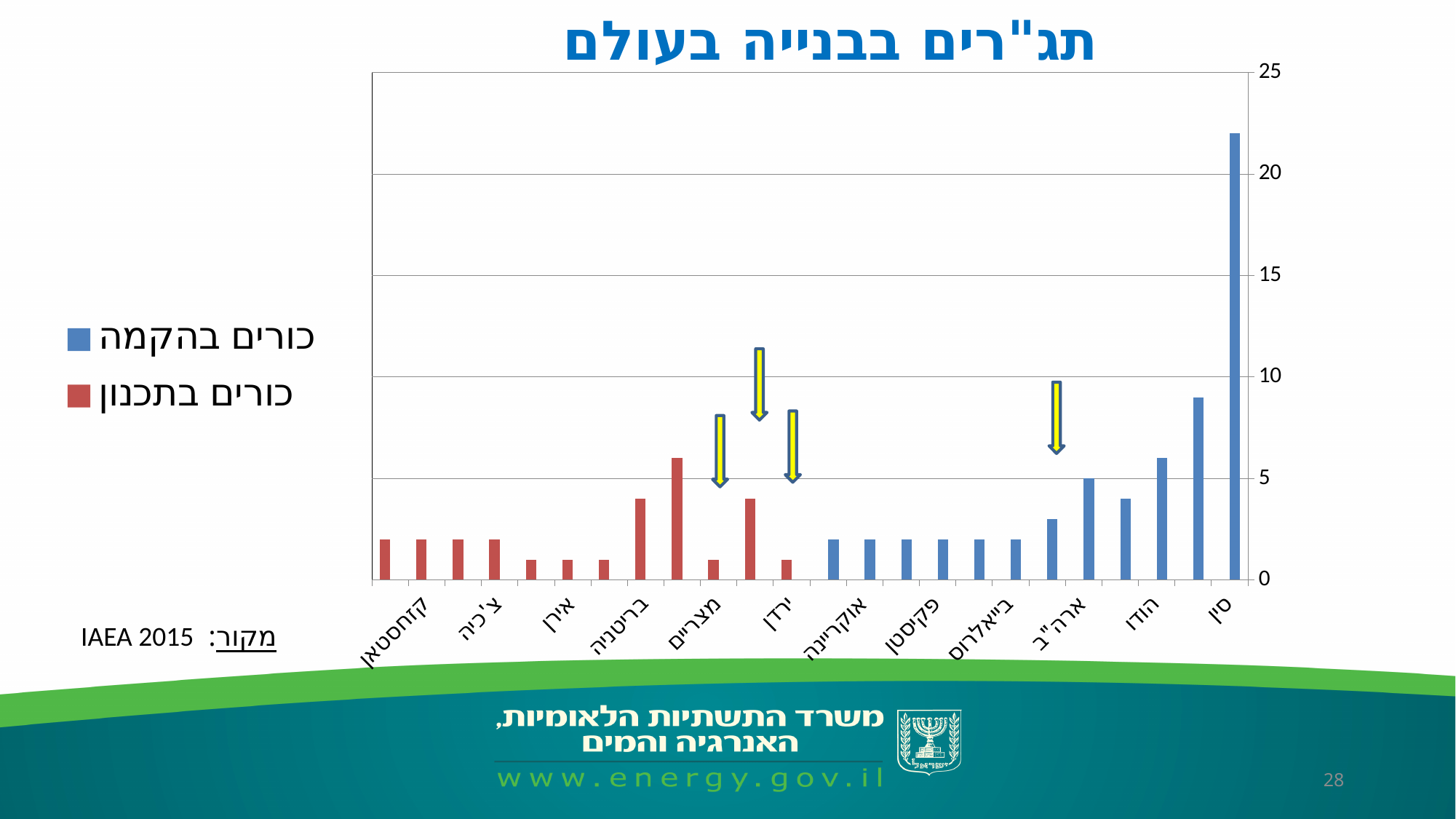
Is the value for סין greater or less than 20? greater What kind of chart is shown on the slide? bar chart Which category has the highest value in the chart? סין Is the value for הודו greater or less than 10? less What source is cited for the chart data? IAEA 2015 Which is larger, the value for סין or the value for הודו? סין How many bars are plotted in the chart? 24 Which legend entry is shown in blue? כורים בהקמה Is the value for ארה"ב greater or less than 10? less How many series does the legend list? 2